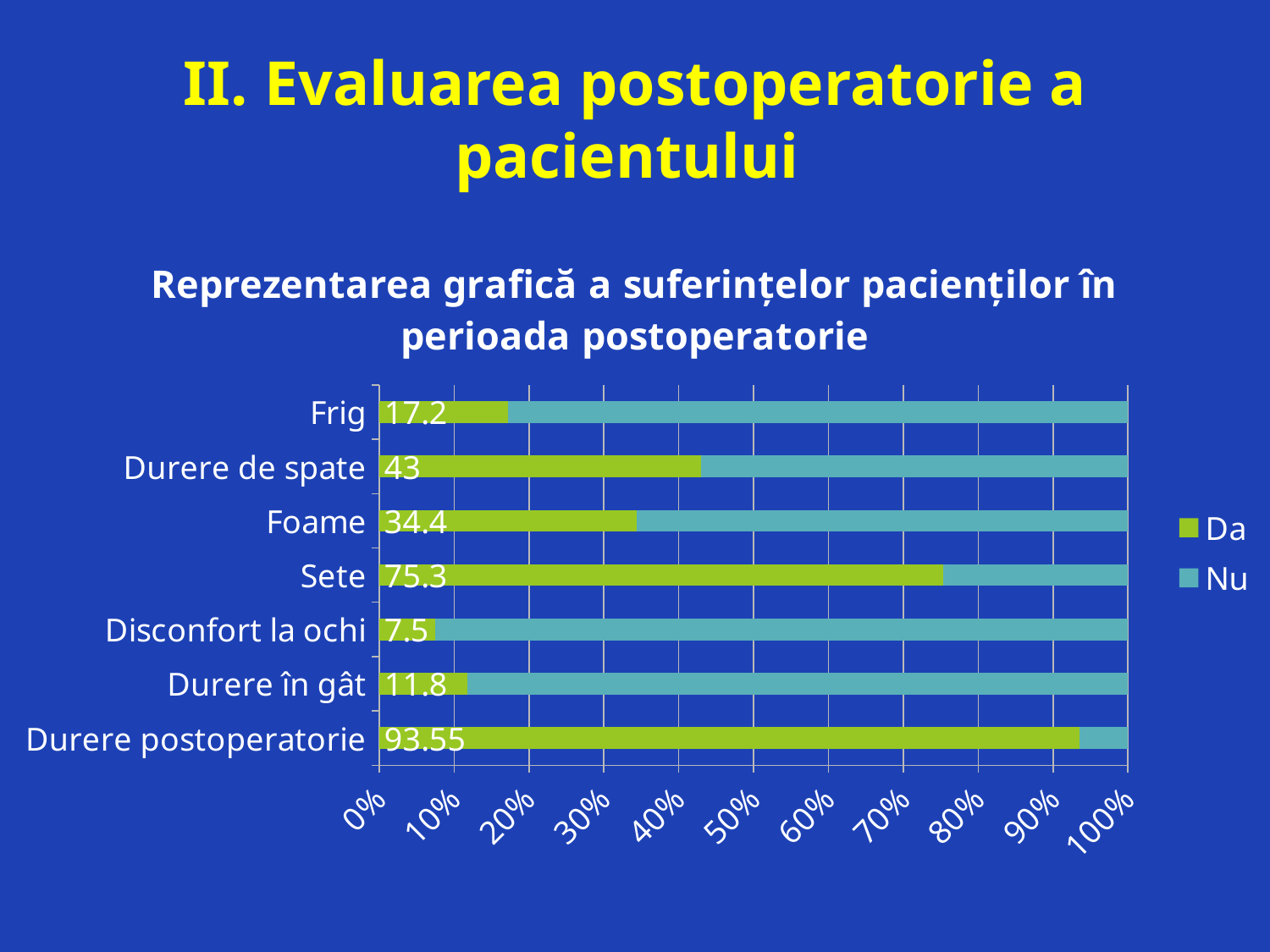
What is the difference between the "Da" values for Sete and Foame? 40.9 What is the "Da" value for Durere de spate? 43 Is the "Nu" value for Frig greater or less than 80%? greater What kind of chart is shown on the slide? Stacked bar chart Is the "Nu" value for Durere postoperatorie greater or less than 10%? less Which category has the lowest "Da" value? Disconfort la ochi Which has a larger "Da" value, Frig or Durere în gât? Frig How many categories are shown on the chart? 7 What is the "Da" value for Disconfort la ochi? 7.5 How many series does the legend list? 2 What is the "Da" value for Sete? 75.3 Which category has the highest "Da" value? Durere postoperatorie